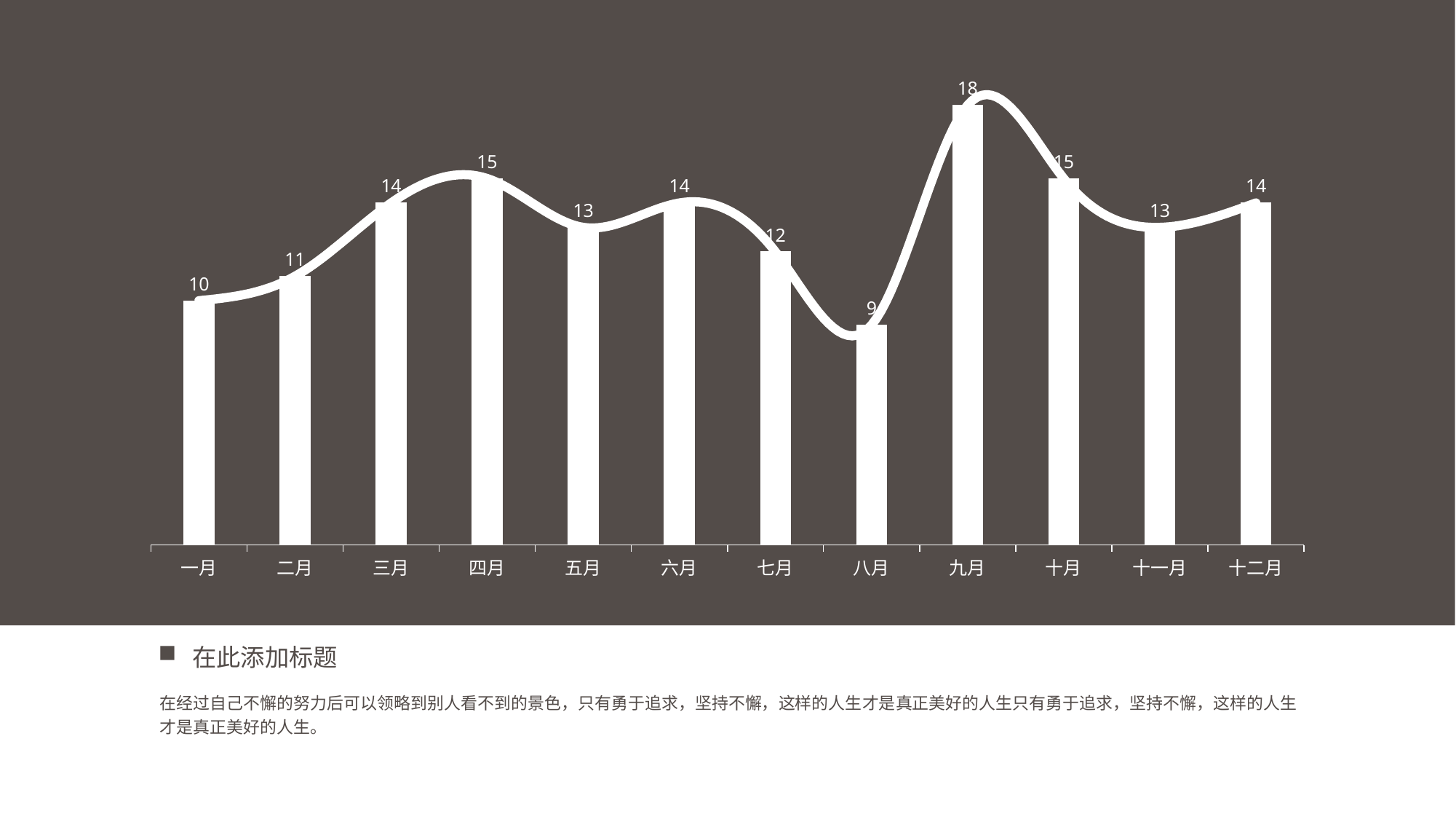
Do the values rise or fall from 一月 to 四月? rise What kind of chart is this? Bar chart with a line overlay What is the value for 九月? 18 Which month has the lowest value? 八月 What is the value for 一月? 10 What is the value for 十二月? 14 Which is larger, the value for 四月 or the value for 五月? 四月 How many months are shown on the x axis? 12 What is the difference between the values for 十月 and 十一月? 2 Which month has the highest value? 九月 What is the value for 八月? 9 What is the difference between the values for 九月 and 八月? 9